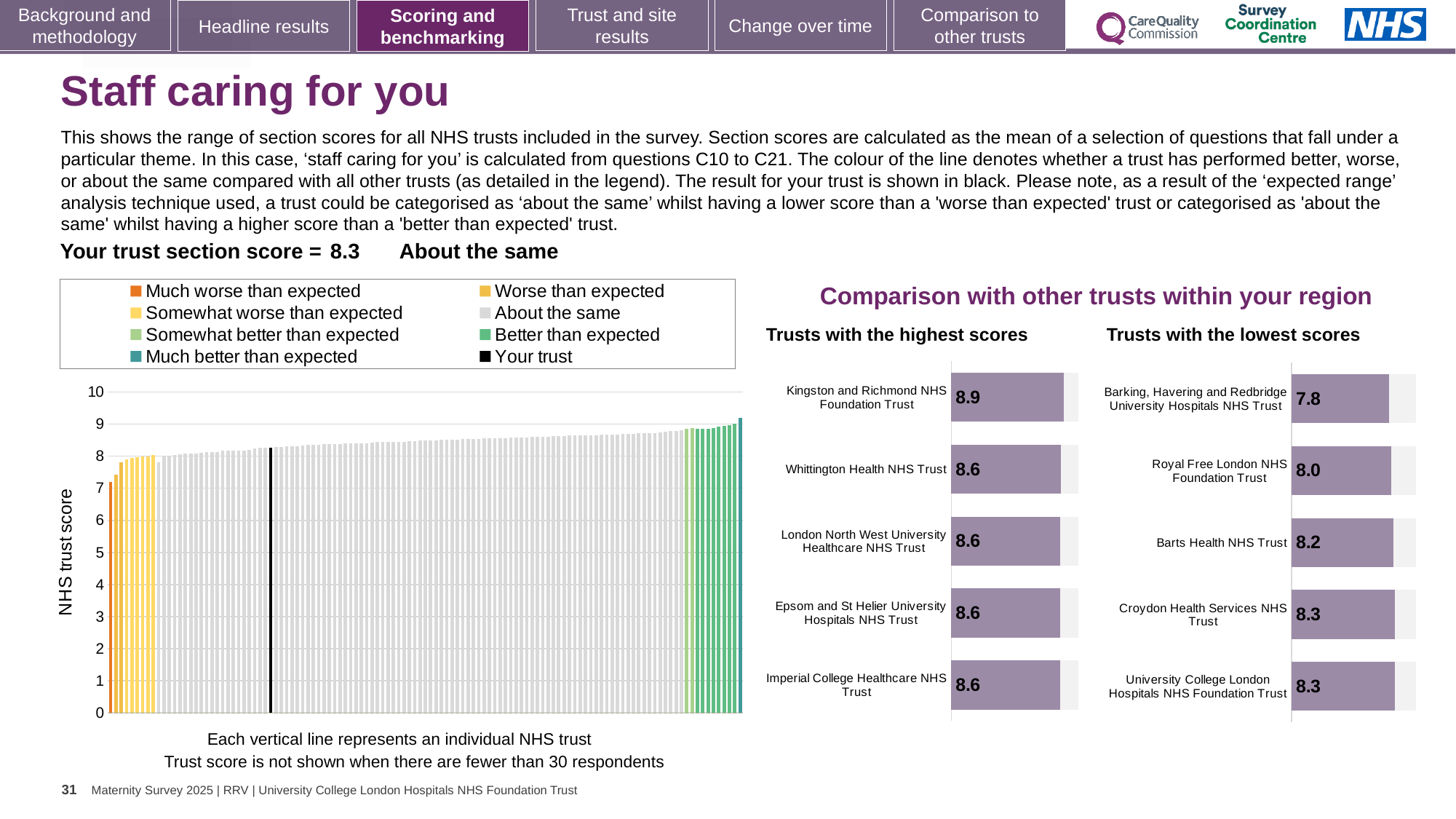
In the 'Trusts with the highest scores' chart, which trust has the highest score? Kingston and Richmond NHS Foundation Trust In the 'Trusts with the highest scores' chart, what is the score for Whittington Health NHS Trust? 8.6 In the 'Trusts with the highest scores' chart, what is the difference between the scores of Kingston and Richmond NHS Foundation Trust and Imperial College Healthcare NHS Trust? 0.3 In the 'Trusts with the highest scores' chart, what is the score for Kingston and Richmond NHS Foundation Trust? 8.9 In the 'Trusts with the lowest scores' chart, what is the difference between the scores of University College London Hospitals NHS Foundation Trust and Barking, Havering and Redbridge University Hospitals NHS Trust? 0.5 In the large 'NHS trust score' chart on the left, do the trust scores rise or fall from left to right along the x axis? rise In the 'Trusts with the lowest scores' chart, what is the score for Barking, Havering and Redbridge University Hospitals NHS Trust? 7.8 How many trusts are shown in the 'Trusts with the lowest scores' chart? 5 In the 'Trusts with the lowest scores' chart, what is the score for Royal Free London NHS Foundation Trust? 8.0 How many entries does the legend of the large 'NHS trust score' chart on the left list? 8 In the 'Trusts with the lowest scores' chart, which has the larger score: Barts Health NHS Trust or Royal Free London NHS Foundation Trust? Barts Health NHS Trust In the 'Trusts with the lowest scores' chart, which trust has the lowest score? Barking, Havering and Redbridge University Hospitals NHS Trust